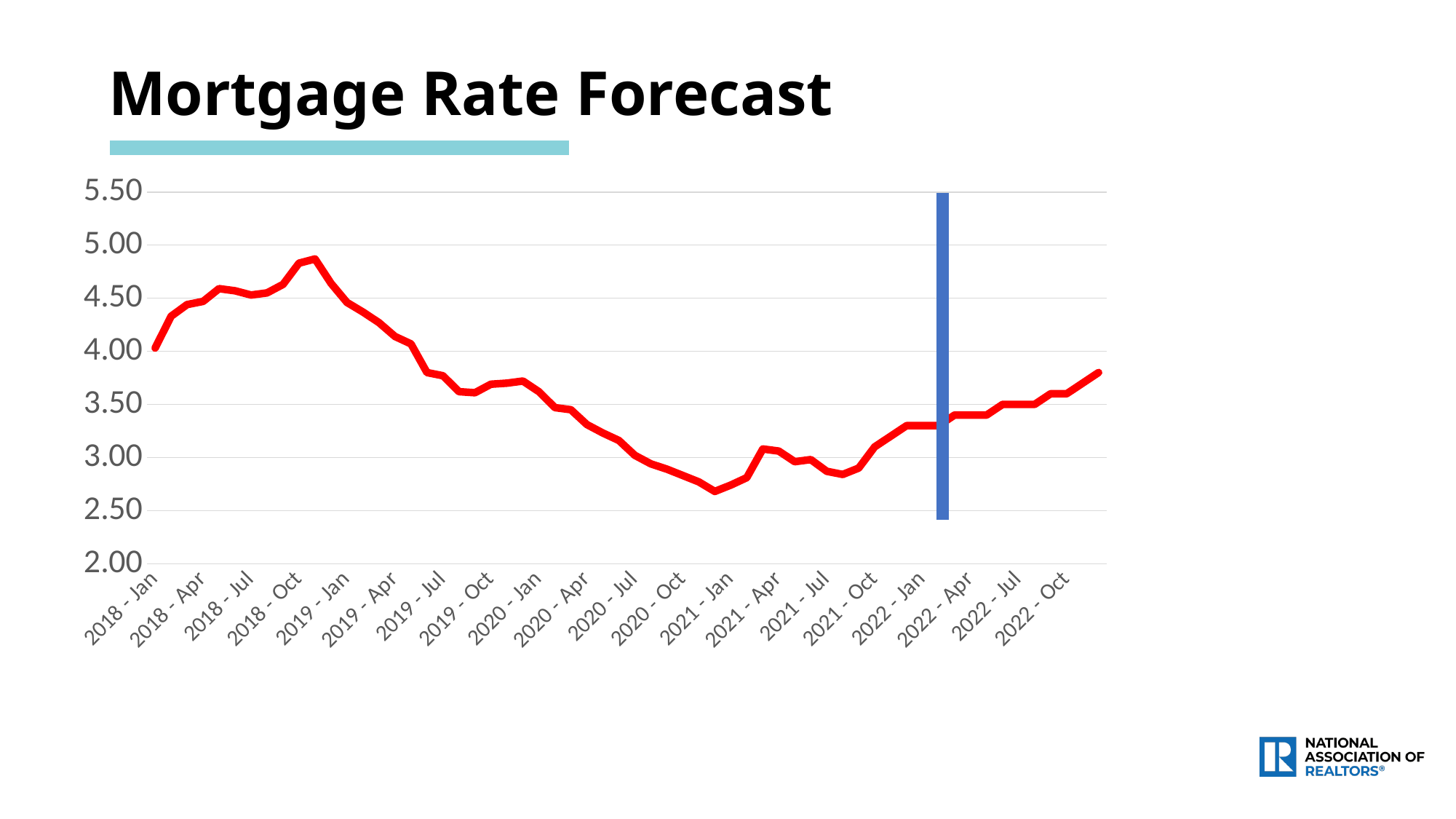
Does the line rise or fall between 2021 - Jan and 2022 - Oct? rise How many labels are shown on the x axis? 20 Around which labeled month is the line at its lowest? 2021 - Jan Is the value for 2021 - Jan greater or less than 3.00? less Is the value for 2022 - Jan greater or less than 3.00? greater In which year does the line reach its highest value? 2018 What is the title of the chart? Mortgage Rate Forecast What kind of chart is shown on the slide? line chart Is the value for 2020 - Jan greater or less than 4.00? less Which is higher, the value for 2019 - Jan or the value for 2021 - Jan? 2019 - Jan What colour is the plotted line? red